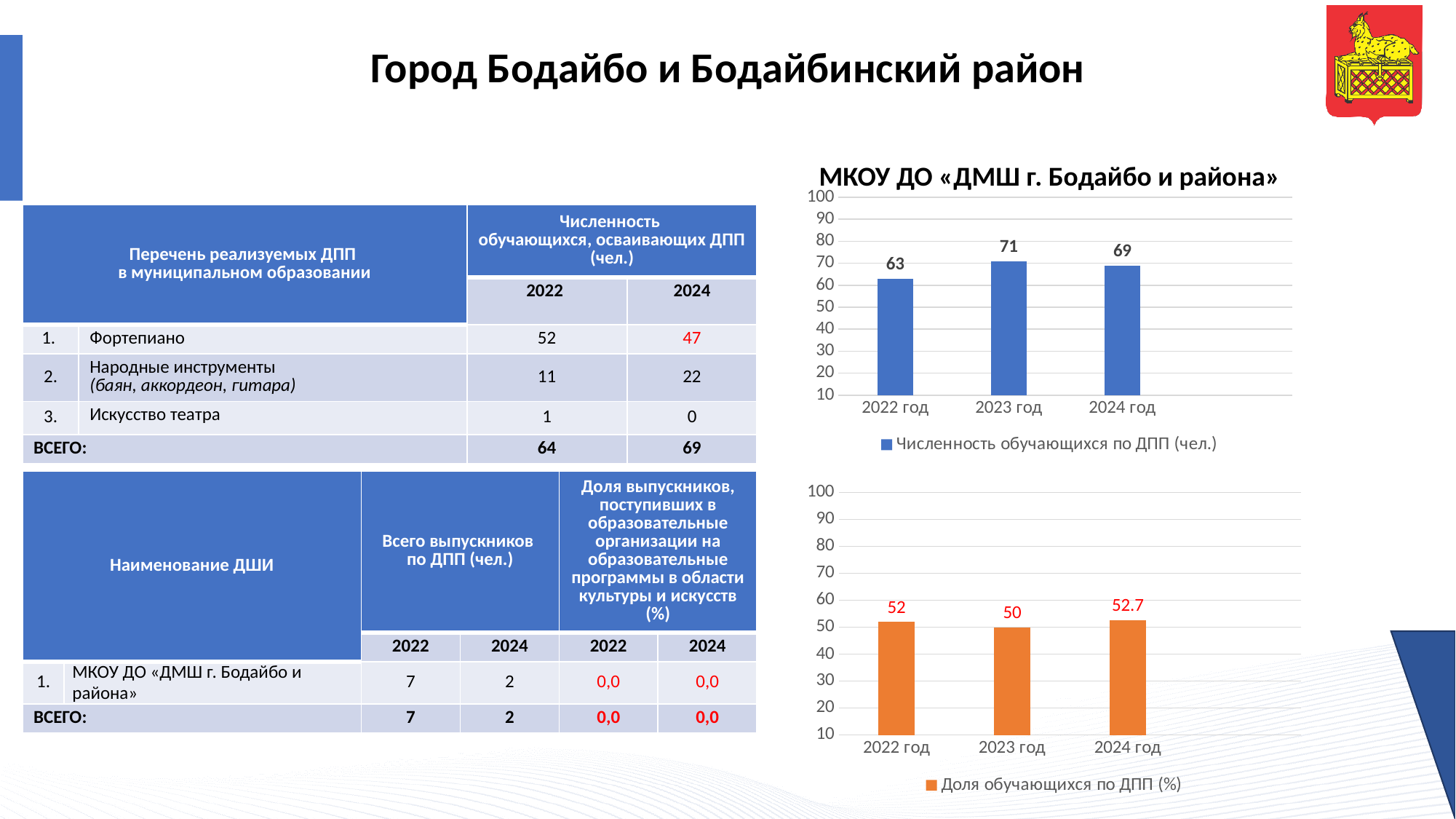
In the bottom chart with the legend «Доля обучающихся по ДПП (%)», which year has the lowest value? 2023 год In the top chart titled «МКОУ ДО «ДМШ г. Бодайбо и района»», how many bars are plotted? 3 In the top chart titled «МКОУ ДО «ДМШ г. Бодайбо и района»», what is the difference between the values for 2023 год and 2022 год? 8 In the top chart titled «МКОУ ДО «ДМШ г. Бодайбо и района»», what is the value for 2023 год? 71 In the top chart titled «МКОУ ДО «ДМШ г. Бодайбо и района»», which year has the highest value? 2023 год In the bottom chart with the legend «Доля обучающихся по ДПП (%)», what kind of chart is shown? Bar chart In the bottom chart with the legend «Доля обучающихся по ДПП (%)», what is the value for 2023 год? 50 In the bottom chart with the legend «Доля обучающихся по ДПП (%)», what colour are the bars? Orange In the top chart titled «МКОУ ДО «ДМШ г. Бодайбо и района»», what series name does the legend show? Численность обучающихся по ДПП (чел.) In the bottom chart with the legend «Доля обучающихся по ДПП (%)», what is the value for 2024 год? 52.7 In the top chart titled «МКОУ ДО «ДМШ г. Бодайбо и района»», what is the value for 2022 год? 63 In the top chart titled «МКОУ ДО «ДМШ г. Бодайбо и района»», which year has the lowest value? 2022 год